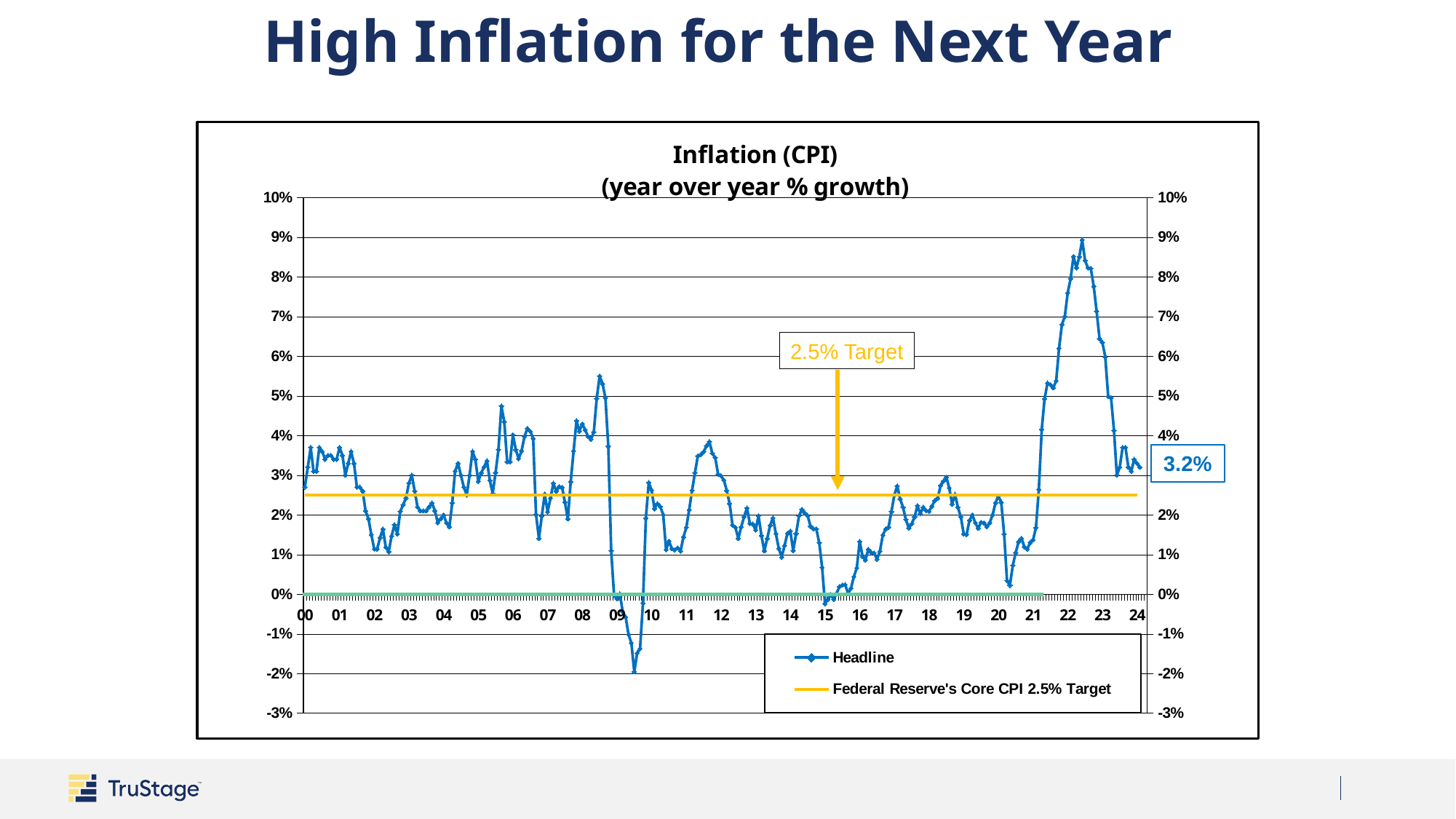
In which year does the Headline series reach its highest value? 22 Is the lowest Headline inflation value in 2009 greater or less than -1%? less Is the Headline inflation value in 2015 greater or less than 1%? less What is the Federal Reserve's Core CPI target value shown on the chart? 2.5% How many series does the legend list? 2 From the 2022 peak to 2024, does the Headline series rise or fall? Fall Is the peak Headline inflation value in 2022 greater or less than 8%? greater What kind of chart is shown on the slide? Line chart What is the most recent Headline inflation value labeled on the chart? 3.2% Which is larger: the latest Headline value of 3.2% or the 2.5% target? 3.2% In which year does the Headline series reach its lowest value? 09 What is the title of the chart? Inflation (CPI) (year over year % growth)